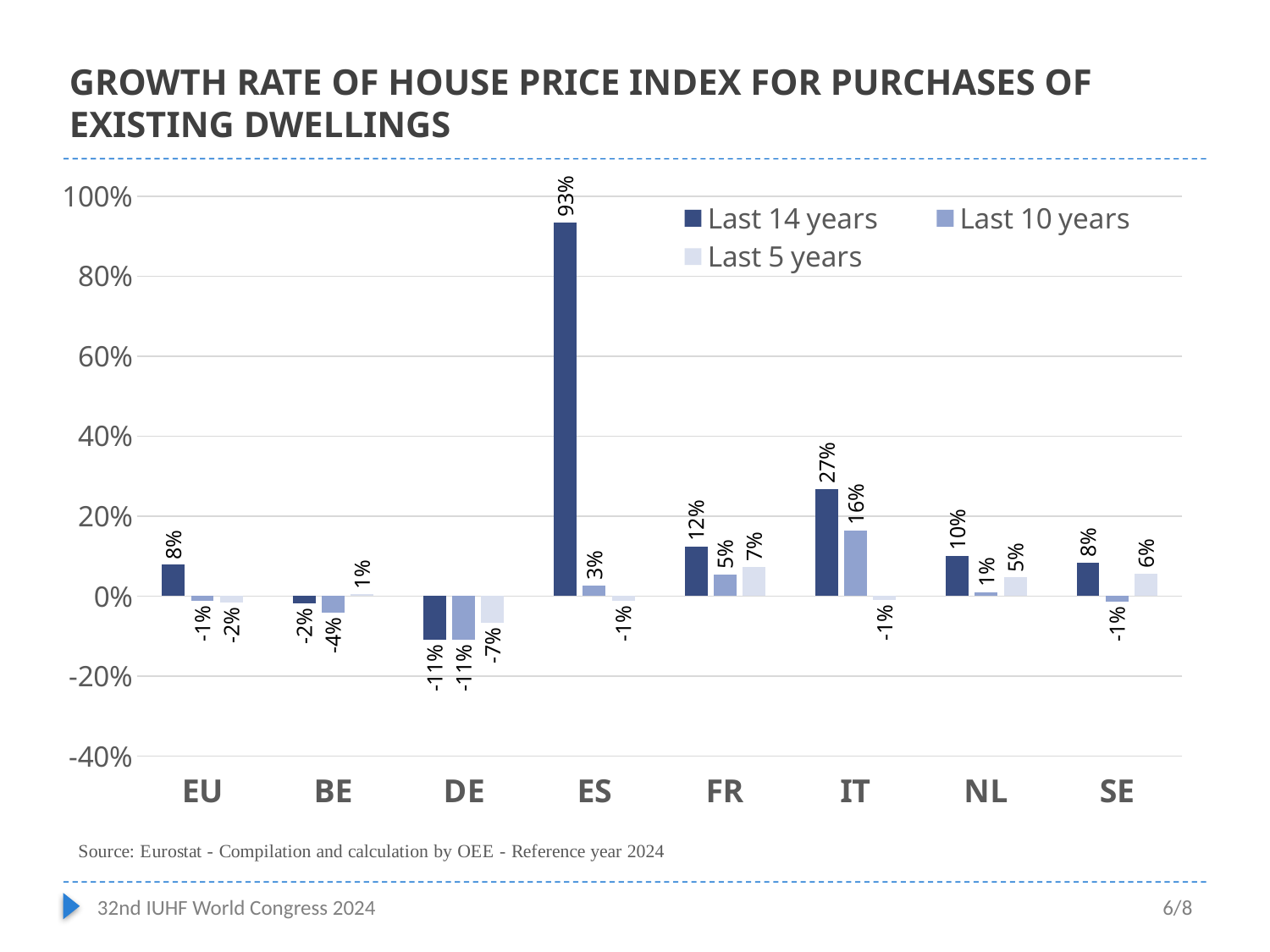
What is the value for FR in the Last 5 years series? 7% How many series does the legend list? 3 Which country has the lowest value in the Last 10 years series? DE How many countries or regions are shown on the x axis? 8 What is the value for ES in the Last 14 years series? 93% What kind of chart is shown on the slide? Bar chart Which is larger, the Last 5 years value for NL or for SE? SE What is the value for DE in the Last 5 years series? -7% Which country has the highest value in the Last 14 years series? ES What is the source cited below the chart? Eurostat - Compilation and calculation by OEE - Reference year 2024 What is the difference between the Last 14 years values for IT and FR? 15% What is the value for IT in the Last 10 years series? 16%